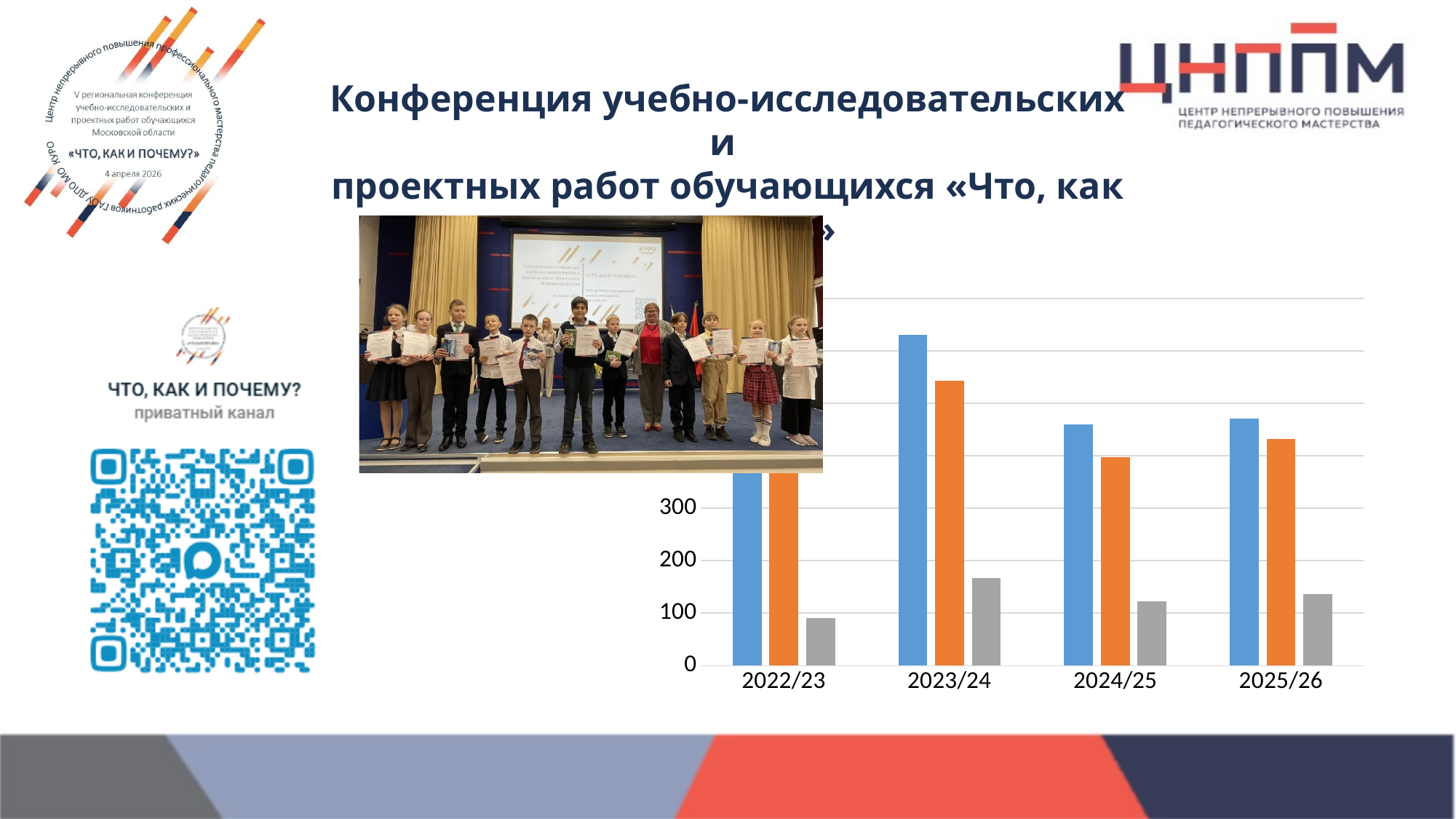
Which is larger, the blue bar for 2023/24 or the blue bar for 2024/25? 2023/24 What kind of chart is shown on the slide? bar chart Which year has the tallest gray bar in the chart? 2023/24 Which year has the shortest gray bar in the chart? 2022/23 How many bars are plotted for each year category in the chart? 3 Is the gray bar for 2022/23 greater or less than 100? less Is the orange bar for 2024/25 greater or less than 300? greater Is the blue bar for 2023/24 greater or less than 300? greater Which is larger, the orange bar for 2023/24 or the orange bar for 2024/25? 2023/24 What is the first year category shown on the x axis of the chart? 2022/23 How many year categories are shown on the x axis of the chart? 4